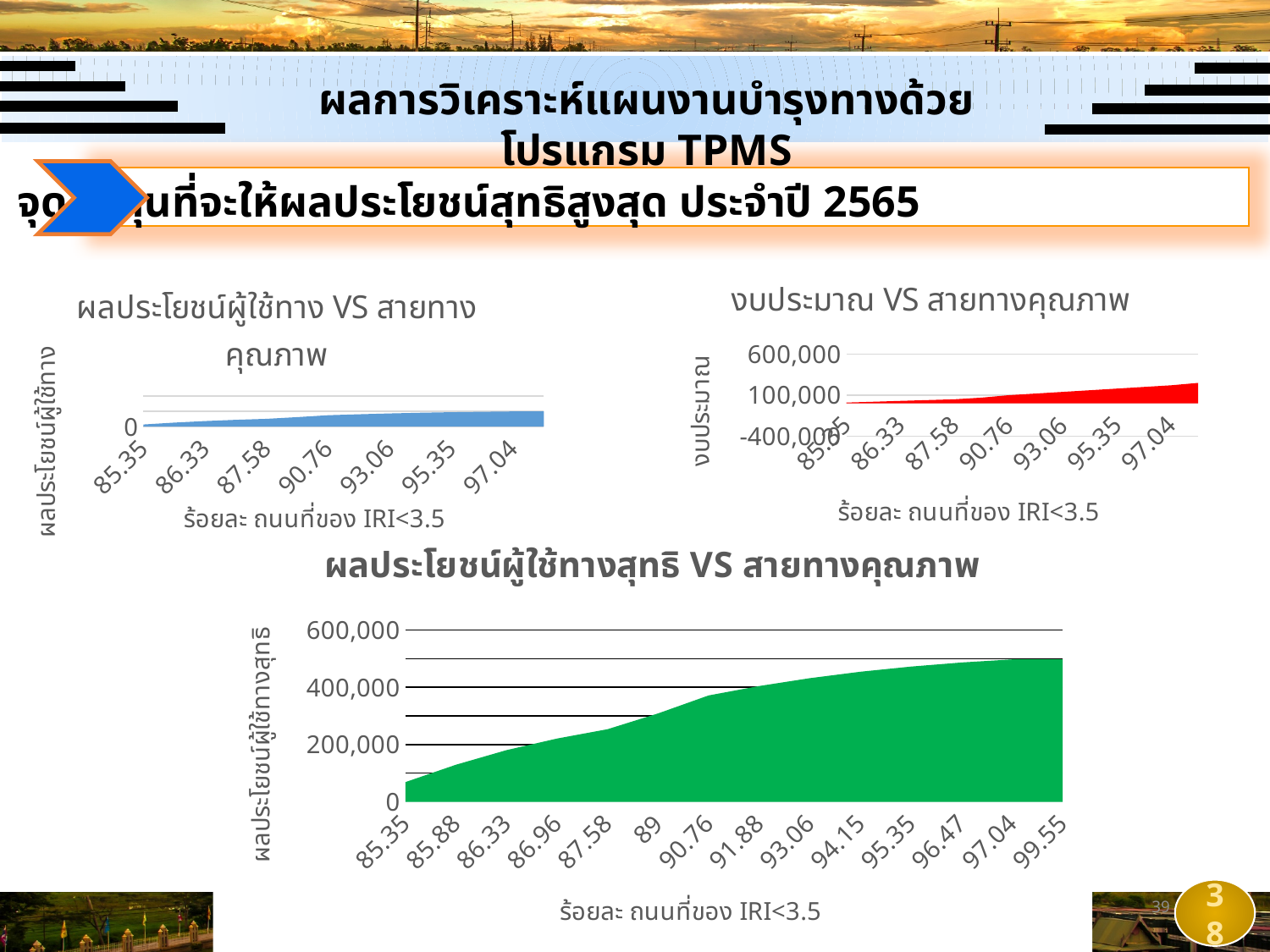
In the bottom chart (ผลประโยชน์ผู้ใช้ทางสุทธิ VS สายทางคุณภาพ), do the values rise or fall along the x axis? Rise What kind of chart is the bottom chart titled ผลประโยชน์ผู้ใช้ทางสุทธิ VS สายทางคุณภาพ? Area chart In the bottom chart (ผลประโยชน์ผู้ใช้ทางสุทธิ VS สายทางคุณภาพ), is the value for 85.35 greater or less than 200,000? less In the bottom chart (ผลประโยชน์ผู้ใช้ทางสุทธิ VS สายทางคุณภาพ), which has the larger value, 85.88 or 96.47? 96.47 In the bottom chart (ผลประโยชน์ผู้ใช้ทางสุทธิ VS สายทางคุณภาพ), is the value for 87.58 greater or less than 200,000? greater In the bottom chart (ผลประโยชน์ผู้ใช้ทางสุทธิ VS สายทางคุณภาพ), which category has the lowest value? 85.35 What is the x-axis title of the bottom chart (ผลประโยชน์ผู้ใช้ทางสุทธิ VS สายทางคุณภาพ)? ร้อยละ ถนนที่ของ IRI<3.5 In the bottom chart (ผลประโยชน์ผู้ใช้ทางสุทธิ VS สายทางคุณภาพ), how many categories are shown on the x axis? 14 In the bottom chart (ผลประโยชน์ผู้ใช้ทางสุทธิ VS สายทางคุณภาพ), is the value for 99.55 greater or less than 400,000? greater In the bottom chart (ผลประโยชน์ผู้ใช้ทางสุทธิ VS สายทางคุณภาพ), which category has the highest value? 97.04 and 99.55 (tied) In the top-right chart (งบประมาณ VS สายทางคุณภาพ), do the values rise or fall along the x axis? Rise